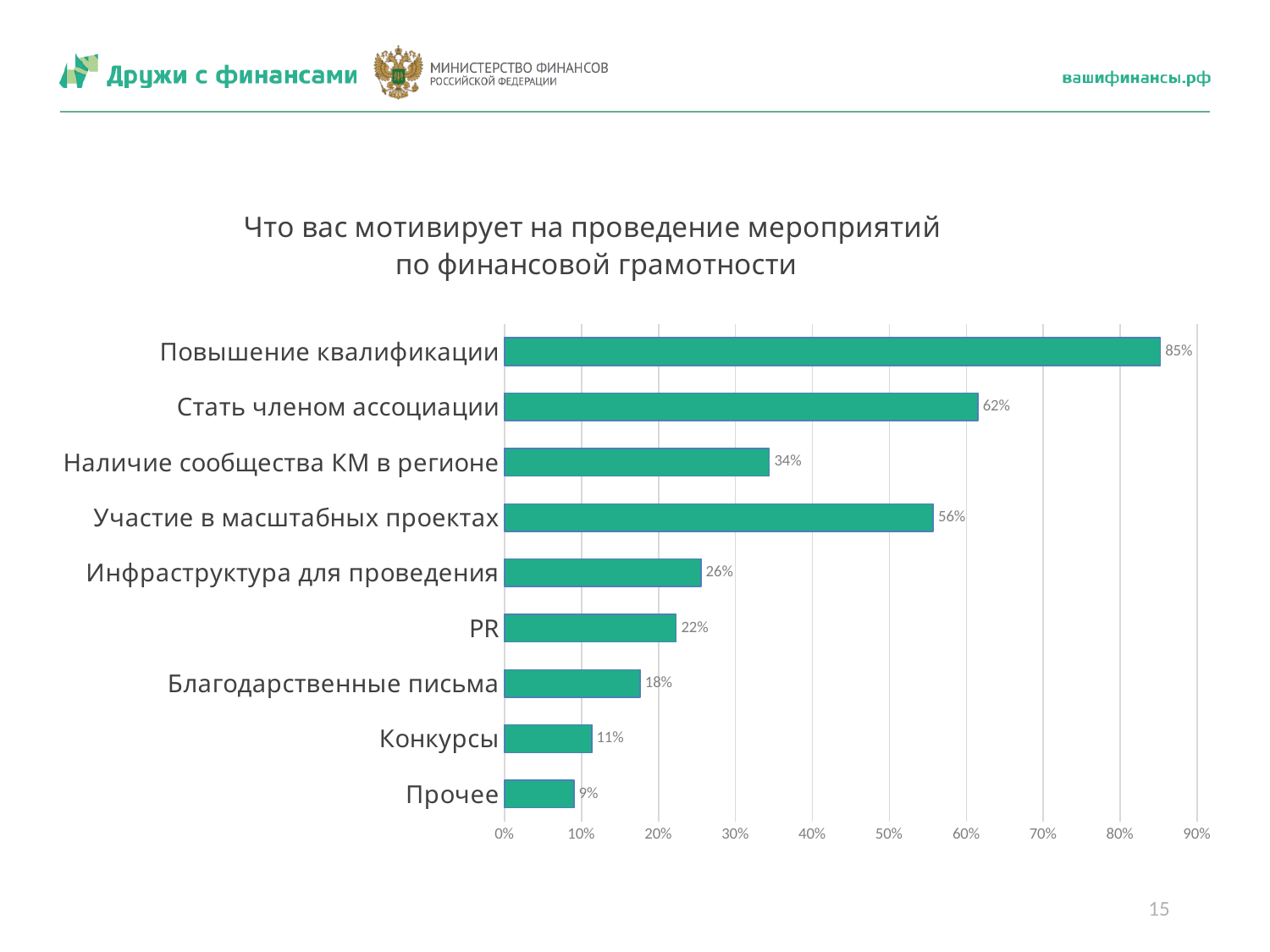
What is the value for Повышение квалификации? 85% What kind of chart is shown on the slide? bar chart What is the title of the chart? Что вас мотивирует на проведение мероприятий по финансовой грамотности What is the value for Участие в масштабных проектах? 56% Which category has the highest value? Повышение квалификации Is the value for Конкурсы greater or less than 20%? less What is the value for PR? 22% How many categories are shown in the chart? 9 What is the highest value shown on the x axis? 90% Which category has the lowest value? Прочее Which is larger, the value for Инфраструктура для проведения or the value for Благодарственные письма? Инфраструктура для проведения What is the difference between the values for Стать членом ассоциации and Наличие сообщества КМ в регионе? 28%